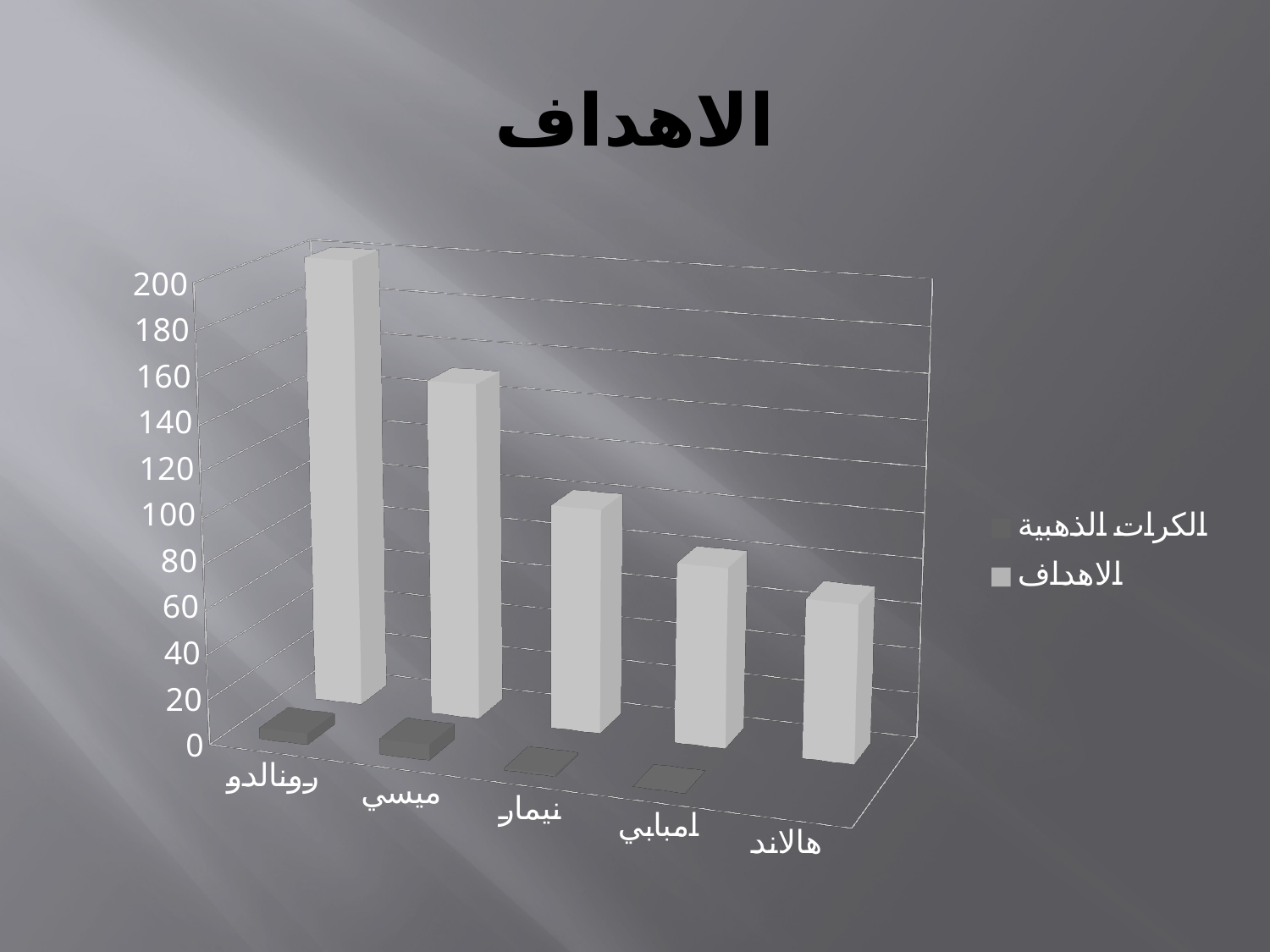
What is the title of the chart? الاهداف Which player has the highest value for الاهداف? رونالدو For الاهداف, which is larger: امبابي or رونالدو? رونالدو How many series does the legend list? 2 Is the الاهداف value for نيمار greater or less than 140? less What kind of chart is shown on the slide? bar chart Do the الاهداف values rise or fall moving from رونالدو to هالاند along the x axis? fall Is the الاهداف value for رونالدو greater or less than 160? greater Which player has the lowest value for الاهداف? هالاند For الاهداف, which is larger: ميسي or نيمار? ميسي Is the الاهداف value for هالاند greater or less than 100? less How many players (categories) are shown on the x axis? 5